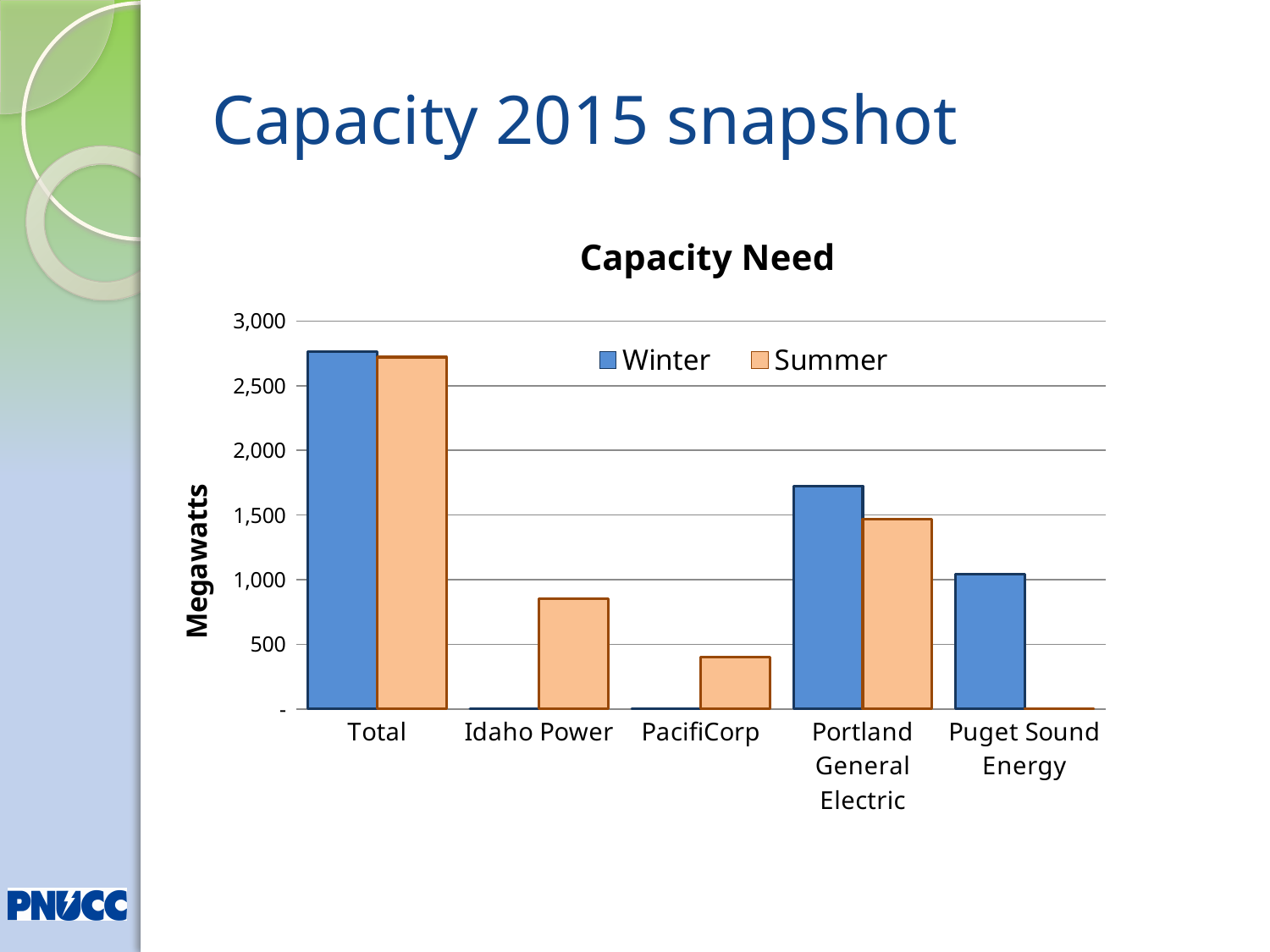
How many categories are shown on the x axis? 5 Is the Summer value for Idaho Power greater or less than 1,000? less Is the Summer value for PacifiCorp greater or less than 500? less What is the title of the y axis? Megawatts How many series does the legend list? 2 Which category has the lowest Summer value? Puget Sound Energy Which category has the highest Winter value? Total Which category has the highest Summer value? Total Is the Winter value for Portland General Electric greater or less than 1,500? greater Which is larger, the Summer value for Idaho Power or the Summer value for PacifiCorp? Idaho Power What kind of chart is shown on the slide? bar chart For Portland General Electric, which is larger, the Winter value or the Summer value? Winter